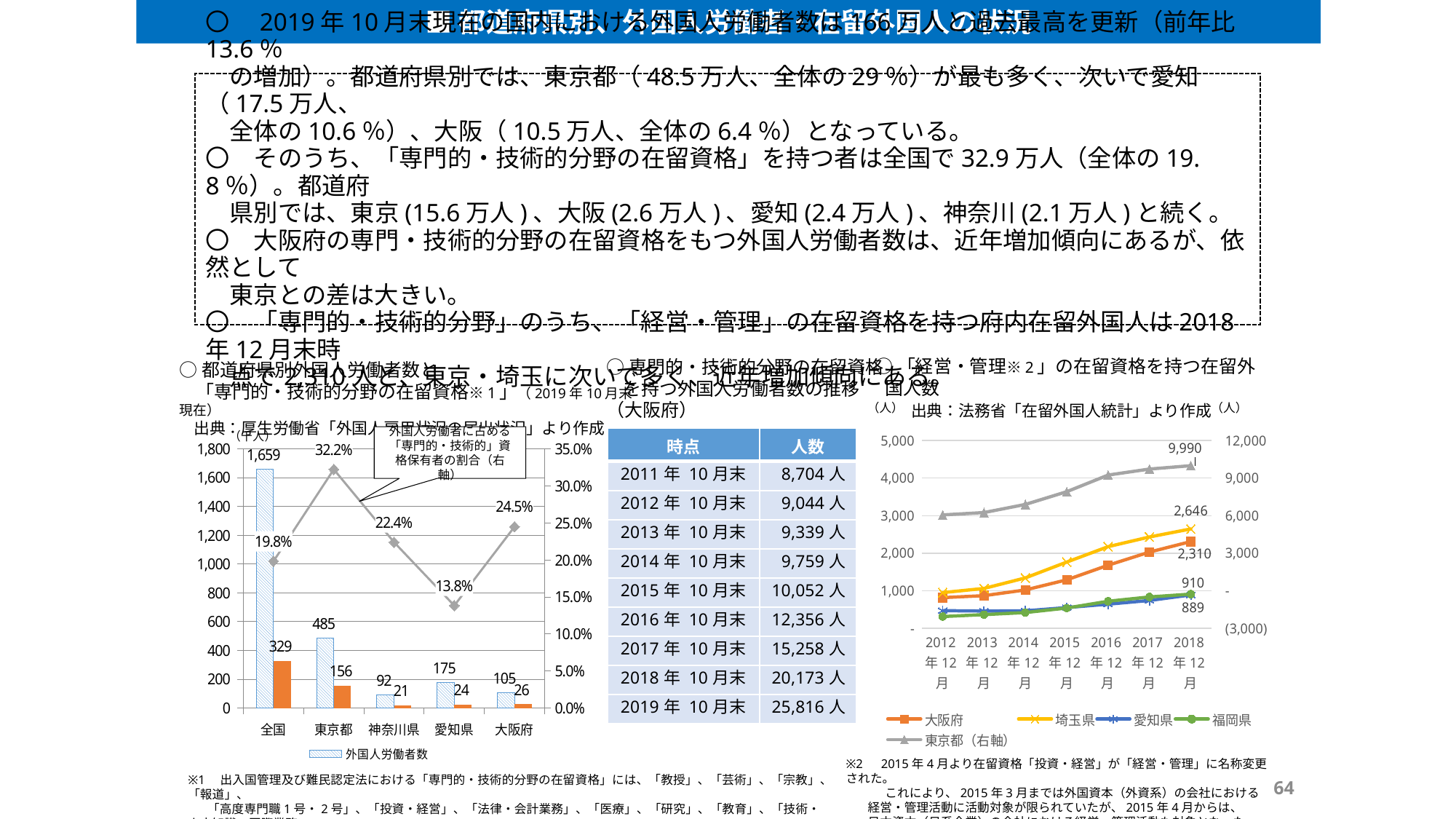
In the right chart (経営・管理 在留資格), what is the 2018年12月 value for 大阪府? 2,310 In the left chart (都道府県別外国人労働者数), what is the difference between the 外国人労働者数 bar for 愛知県 and for 大阪府? 70 In the left chart (都道府県別外国人労働者数), how many prefecture/region categories are shown on the x axis? 5 In the left chart (都道府県別外国人労働者数), which is larger: the 外国人労働者数 bar for 神奈川県 or for 大阪府? 大阪府 In the left chart (都道府県別外国人労働者数), what is the value of the 外国人労働者数 bar for 全国? 1,659 In the right chart (経営・管理 在留資格), what is the 2018年12月 value for 東京都 (右軸)? 9,990 In the right chart (経営・管理 在留資格), how many series does the legend list? 5 In the right chart (経営・管理 在留資格), does the 大阪府 line rise or fall from 2012 to 2018? rise In the left chart (都道府県別外国人労働者数), what percentage is shown on the line for 愛知県? 13.8% In the left chart (都道府県別外国人労働者数), which category has the highest percentage on the line (right axis)? 東京都 What kind of chart is the right chart (経営・管理 在留資格)? line chart In the left chart (都道府県別外国人労働者数), what is the value of the orange bar for 東京都? 156